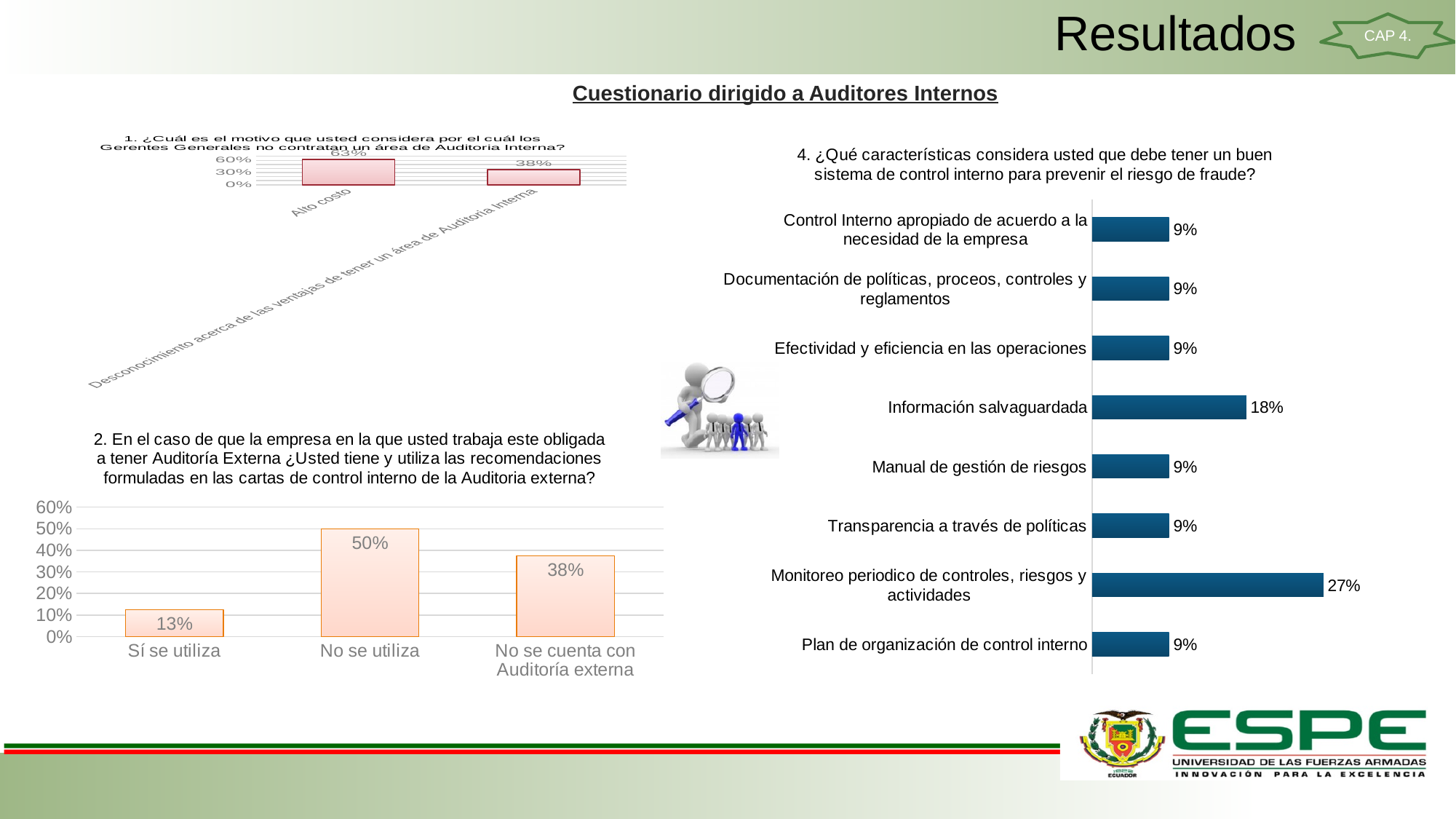
How many categories are shown in the right-hand chart (question 4)? 8 In the right-hand chart (question 4), what is the value for "Monitoreo periodico de controles, riesgos y actividades"? 27% In the right-hand chart (question 4), which category has the highest value? Monitoreo periodico de controles, riesgos y actividades In the bottom-left chart (question 2), what is the value for "No se utiliza"? 50% In the bottom-left chart (question 2), what is the difference between "No se utiliza" and "No se cuenta con Auditoría externa"? 12% How many categories are shown in the bottom-left chart (question 2)? 3 In the top-left chart (question 1), which is larger: "Alto costo" or "Desconocimiento acerca de las ventajas de tener un área de Auditoria Interna"? Alto costo In the top-left chart (question 1), what is the value for "Alto costo"? 63% What kind of chart is the right-hand chart (question 4)? Bar chart In the bottom-left chart (question 2), what is the value for "Sí se utiliza"? 13% In the right-hand chart (question 4), what is the value for "Información salvaguardada"? 18% In the bottom-left chart (question 2), which category has the lowest value? Sí se utiliza